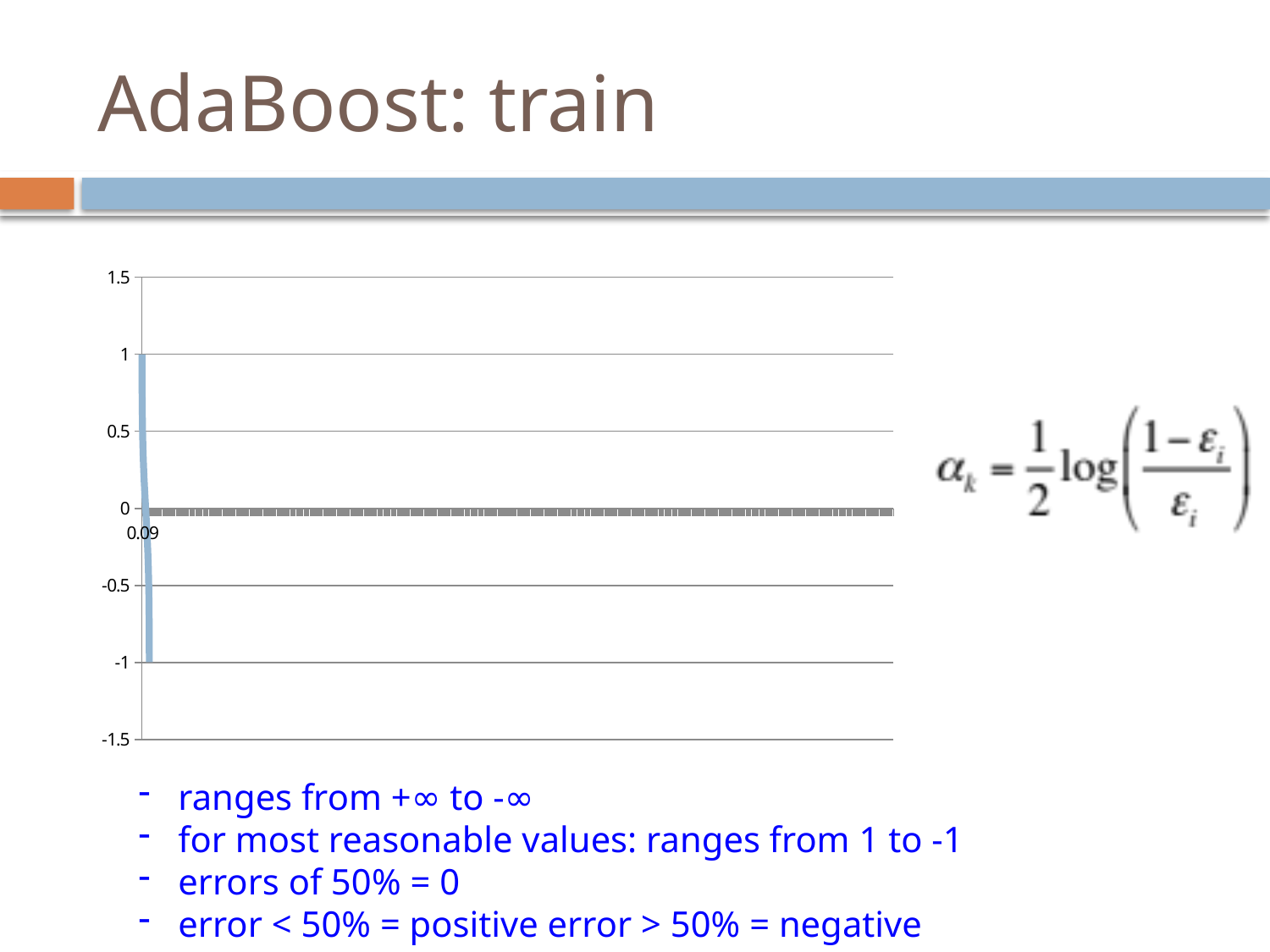
Is the lowest plotted value of the line greater or less than -0.5? less What kind of chart is shown on the slide? line chart Is the ending value of the line greater or less than 0? less What is the lowest tick value shown on the y axis? -1.5 Is the highest plotted value of the line greater or less than 0.5? greater What is the highest tick value shown on the y axis? 1.5 Do the plotted values rise or fall as you move along the x axis? fall